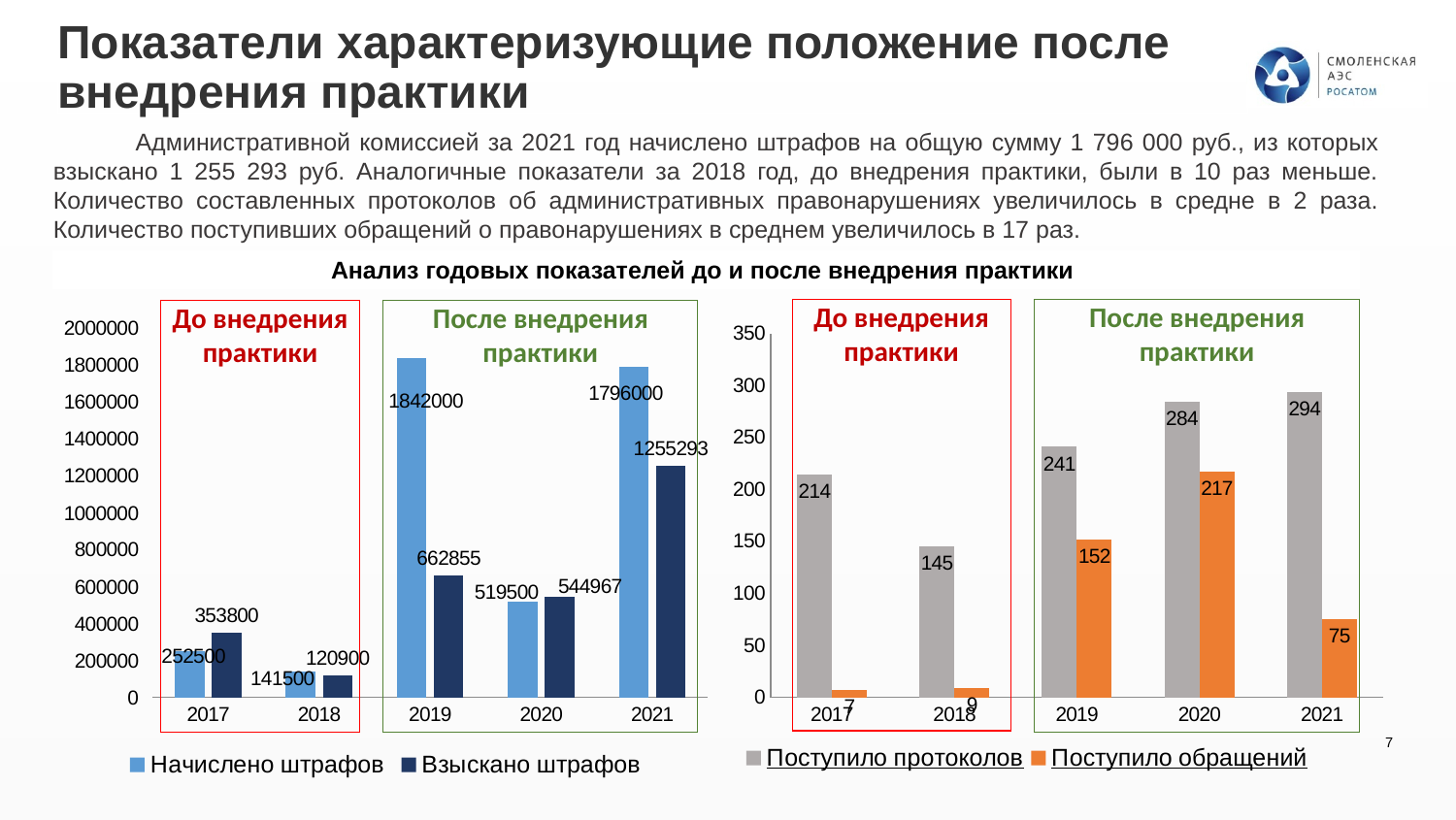
In the left chart, which year has the lowest value for Взыскано штрафов? 2018 In the right chart, what is the value of Поступило обращений for 2020? 217 What type of chart is the left chart? Bar chart In the right chart, what is the difference between Поступило протоколов and Поступило обращений for 2021? 219 In the left chart, which is larger for 2020: Начислено штрафов or Взыскано штрафов? Взыскано штрафов In the left chart, what is the value of Начислено штрафов for 2019? 1842000 In the left chart, what is the difference between Начислено штрафов and Взыскано штрафов for 2019? 1179145 How many series does the legend of the right chart list? 2 In the right chart, which year has the highest value for Поступило протоколов? 2021 In the left chart, what is the value of Взыскано штрафов for 2021? 1255293 In the left chart, which year has the highest value for Начислено штрафов? 2019 In the right chart, which year has the lowest value for Поступило обращений? 2017